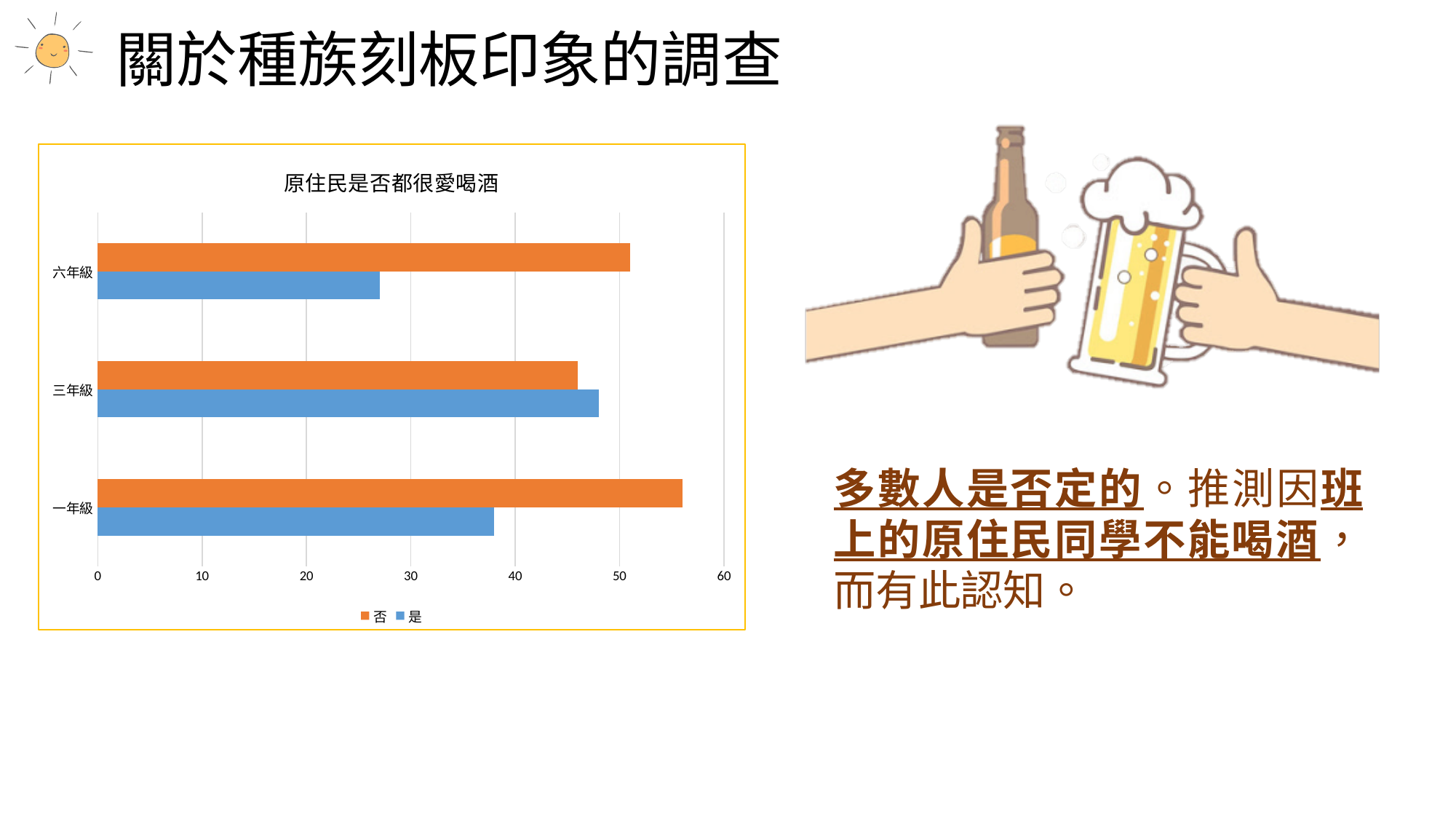
Which series is shown in orange in the chart? 否 Which grade has the lowest value for 是? 六年級 For 六年級, which is larger, 否 or 是? 否 Is the value for 否 in 六年級 greater or less than 40? greater What type of chart is shown on the slide? bar chart How many series does the chart legend list? 2 Is the value for 是 in 六年級 greater or less than 30? less Which grade has the highest value for 否? 一年級 What is the title of the chart? 原住民是否都很愛喝酒 How many grade categories are shown on the chart? 3 Is the value for 否 in 一年級 greater or less than 50? greater